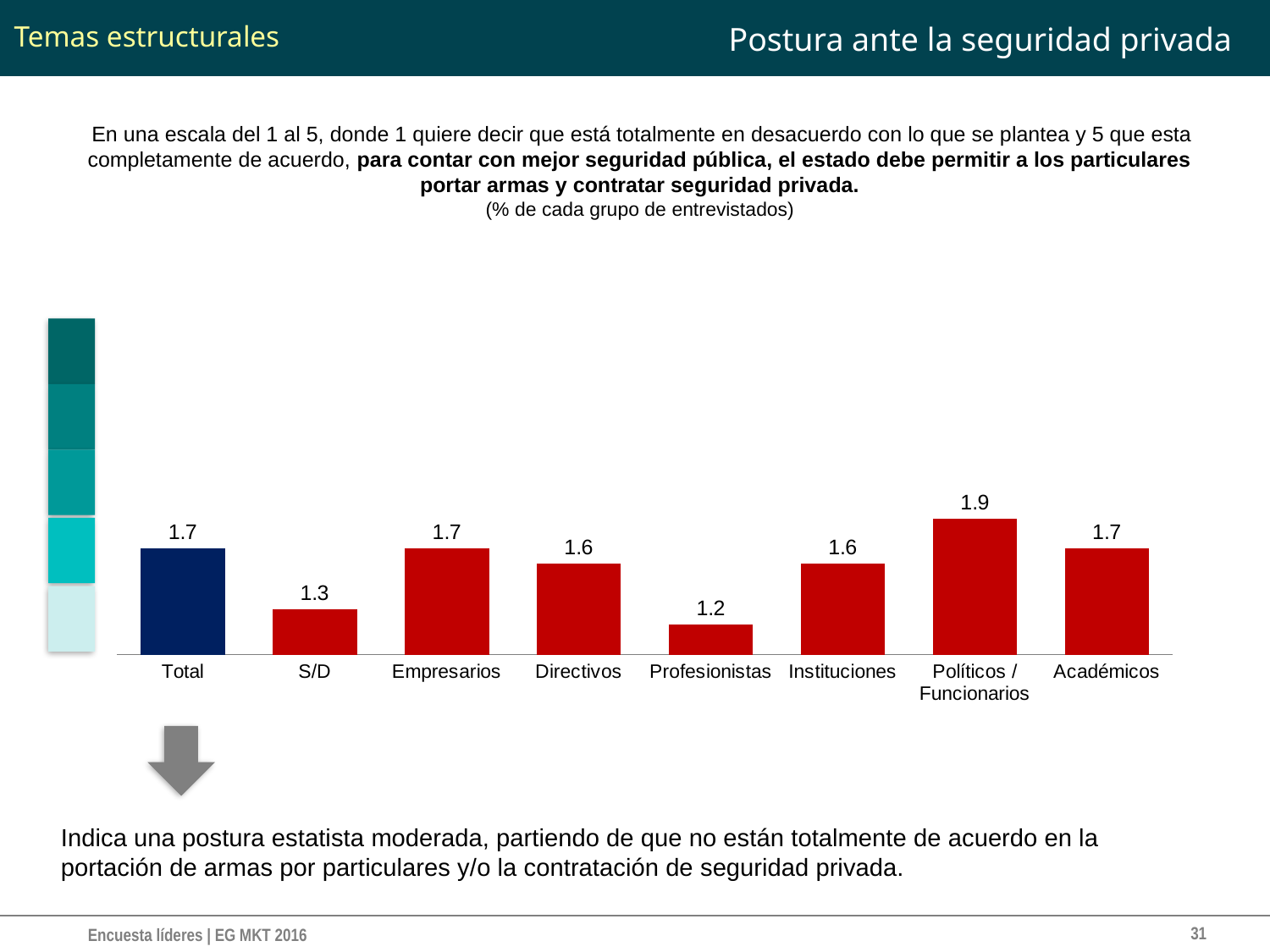
What is the difference between the values for Directivos and S/D? 0.3 Which bar is shown in a different colour (dark blue) from the others? Total What is the value for Políticos / Funcionarios? 1.9 What kind of chart is shown on the slide? Bar chart What is the value for S/D? 1.3 How many categories are shown on the x axis? 8 Which category has the lowest value? Profesionistas Which category has the highest value? Políticos / Funcionarios Which is larger, the value for Empresarios or the value for S/D? Empresarios What is the value for Total? 1.7 What is the value for Profesionistas? 1.2 What is the difference between the values for Políticos / Funcionarios and Profesionistas? 0.7